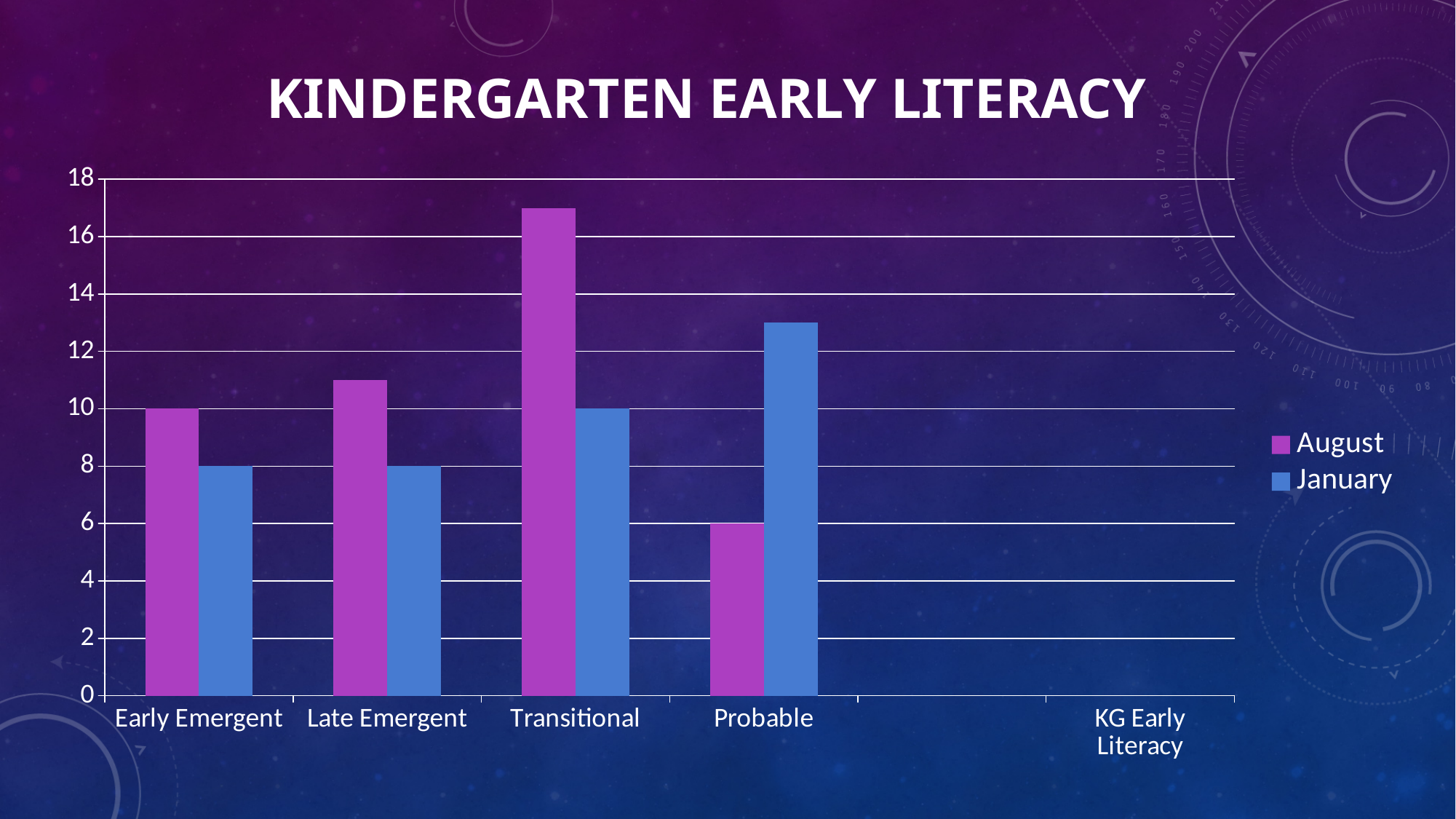
What is the August value for Early Emergent? 10 Is the January value for Probable greater or less than 12? greater Which category has the highest August value? Transitional Which category has the lowest August value? Probable What is the difference between the August and January values for Early Emergent? 2 What is the January value for Early Emergent? 8 How many series does the legend list? 2 Is the August value for Transitional greater or less than 16? greater What is the August value for Probable? 6 What type of chart is shown on the slide? bar chart For Probable, which is larger, the August value or the January value? January What is the January value for Transitional? 10